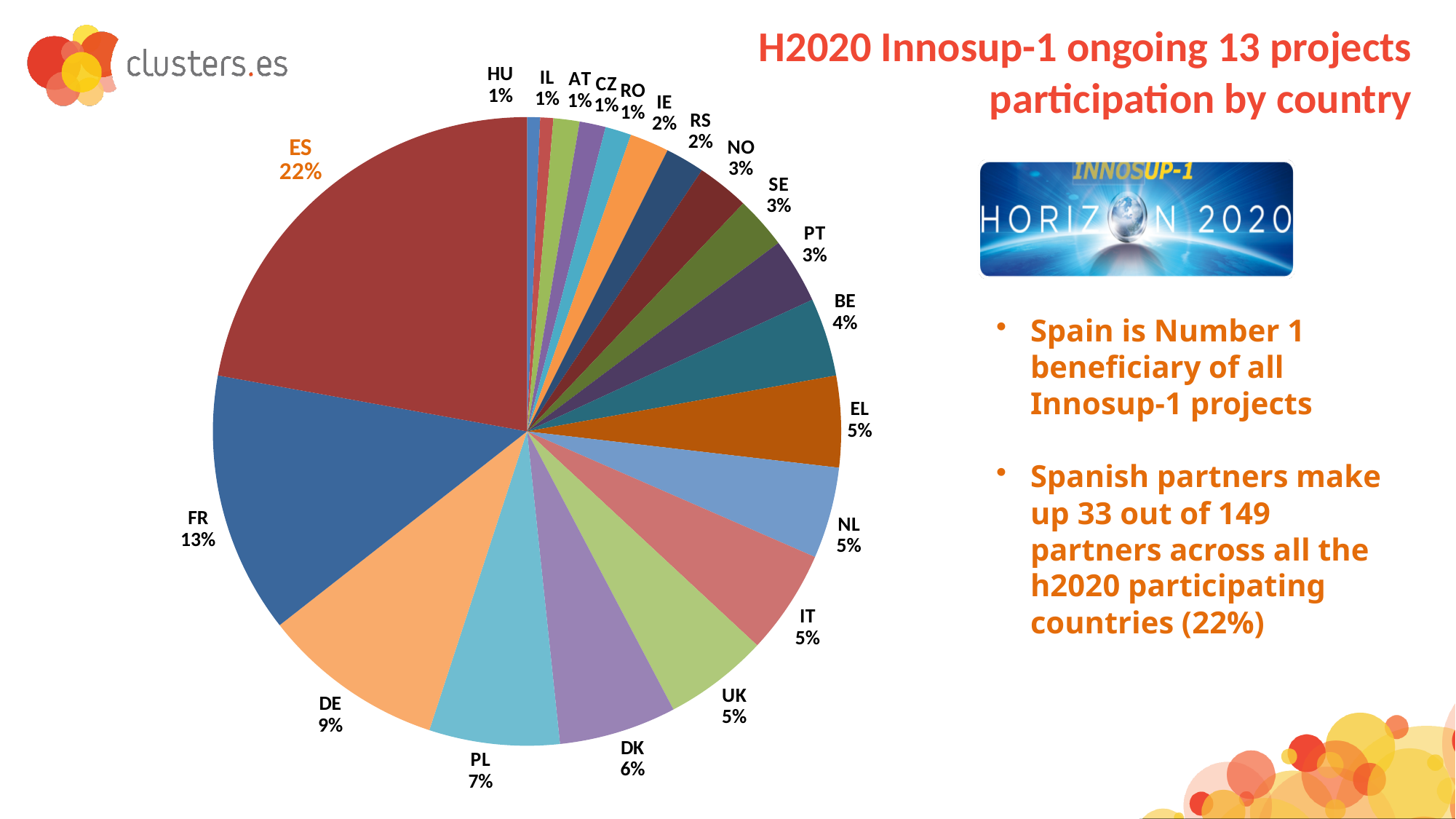
How many percentage points larger is the share for FR than the share for DE? 4 What share of participation does DE have? 9% How many countries are shown in the pie chart? 20 What share of participation does ES have? 22% How many percentage points larger is the share for ES than the share for FR? 9 What share of participation does PL have? 7% What type of chart is shown on the slide? pie chart What is the title of the chart? H2020 Innosup-1 ongoing 13 projects participation by country Which country has the largest share of participation? ES Which has a larger share, PL or DK? PL What share of participation does FR have? 13% What share of participation does BE have? 4%